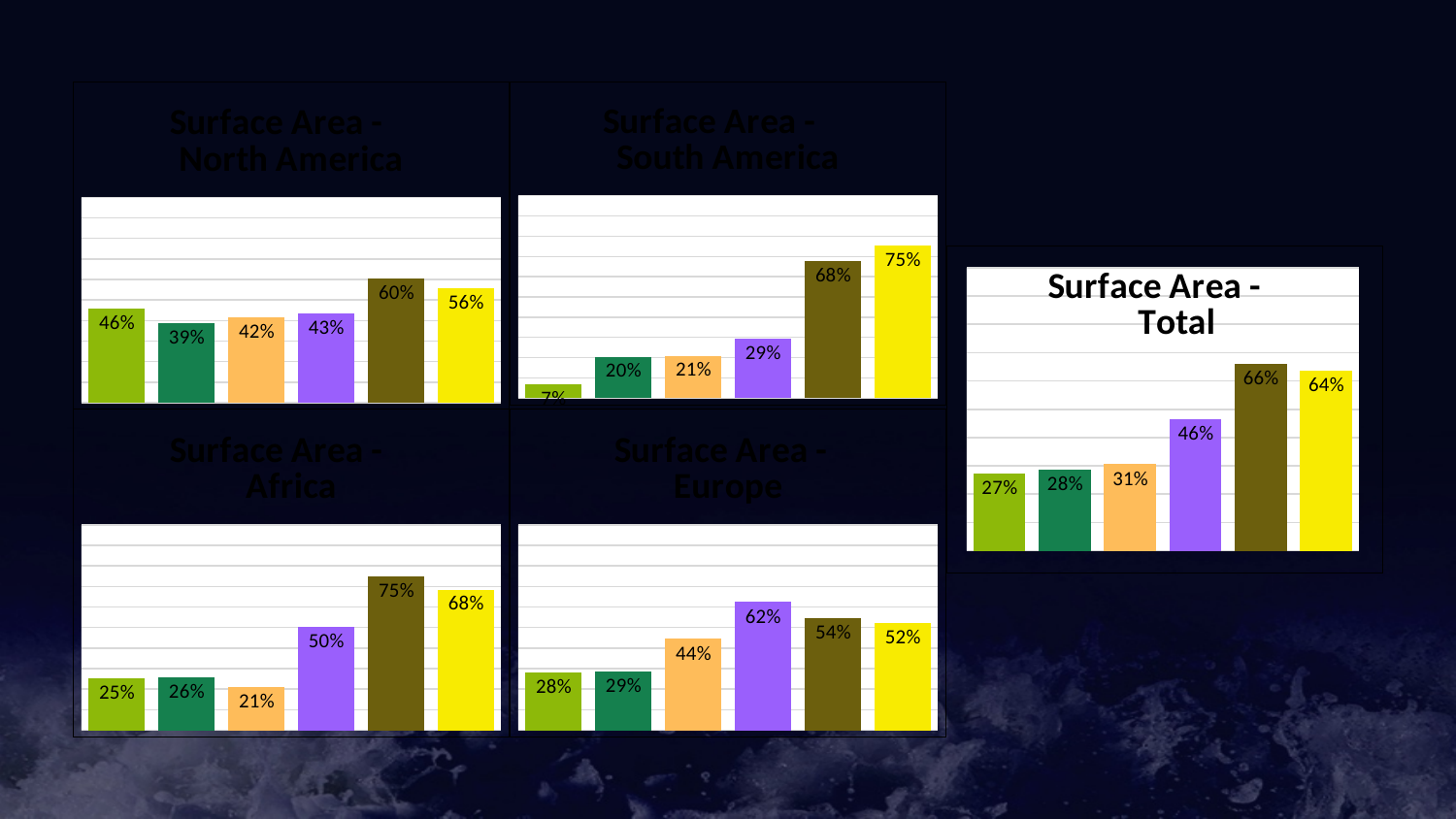
In the "Surface Area - Europe" chart, what is the value of the purple bar? 62% In the "Surface Area - Total" chart, which bar has the highest value? The fifth (dark olive) bar, 66% In the "Surface Area - Total" chart, what is the difference between the fifth (dark olive) bar and the sixth (yellow) bar? 2% In the "Surface Area - Total" chart, what is the value of the fourth (purple) bar? 46% How many bars are plotted in the "Surface Area - Europe" chart? 6 What type of chart is "Surface Area - Total"? Bar chart In the "Surface Area - Africa" chart, which is larger: the purple bar or the orange bar? The purple bar (50%) In the "Surface Area - Africa" chart, what is the difference between the dark olive bar and the yellow bar? 7% In the "Surface Area - North America" chart, what is the value of the first (green) bar? 46% In the "Surface Area - South America" chart, what is the value of the last (yellow) bar? 75% In the "Surface Area - North America" chart, what is the highest value shown? 60% In the "Surface Area - Total" chart, what is the lowest value shown? 27%